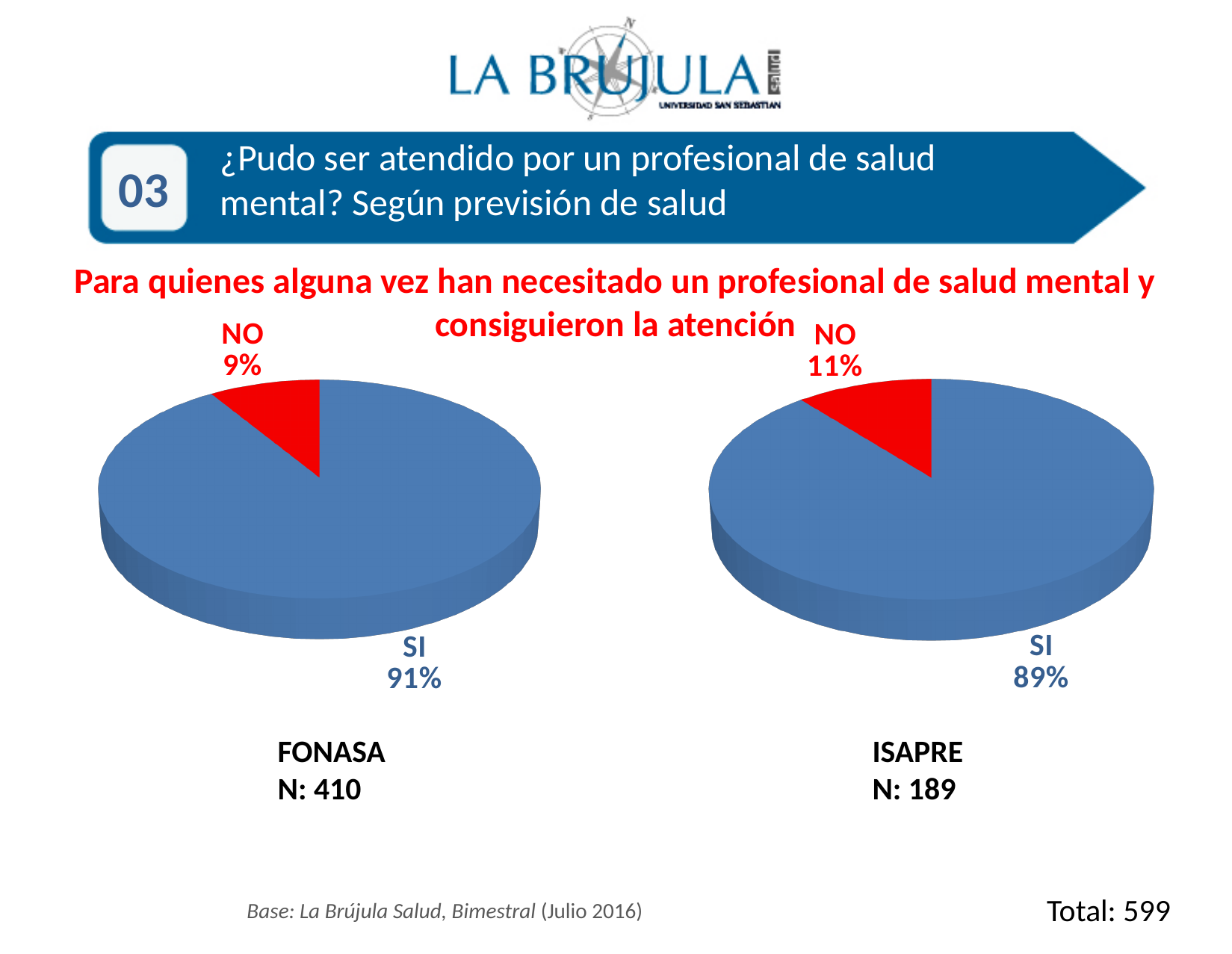
What is the difference between the SI share in the FONASA chart and the SI share in the ISAPRE chart? 2% In the ISAPRE pie chart, which category has the smallest share? NO What is the sample size (N) shown for the FONASA chart? 410 In the ISAPRE pie chart, what percentage answered NO? 11% In the FONASA pie chart, which category has the largest share? SI In the FONASA pie chart, what percentage answered NO? 9% Which is larger: the NO share in the FONASA chart or the NO share in the ISAPRE chart? ISAPRE In the FONASA pie chart, what percentage answered SI? 91% In the ISAPRE pie chart, what percentage answered SI? 89% What type of chart is used for the ISAPRE data? Pie chart What colour is the NO slice in the ISAPRE pie chart? Red How many slices does the FONASA pie chart have? 2